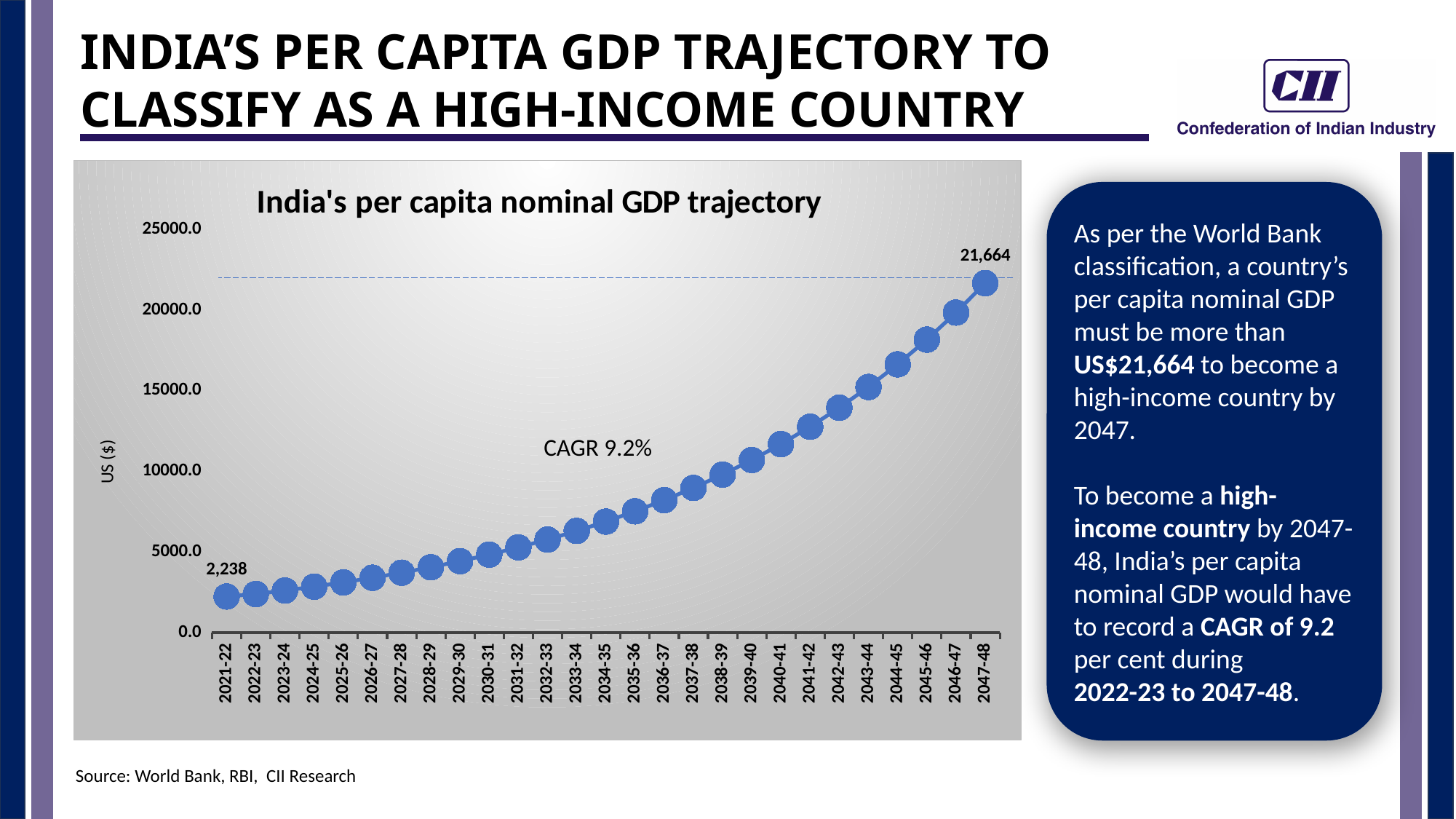
Which year has the lowest per capita nominal GDP on the chart? 2021-22 Is the value for 2044-45 greater or less than 15000? greater Which year has the highest per capita nominal GDP on the chart? 2047-48 Is the value for 2035-36 greater or less than 10000? less What is the per capita nominal GDP value shown for 2021-22? 2,238 Is the value for 2040-41 greater or less than 10000? greater What is the difference between the 2047-48 value and the 2021-22 value? 19,426 How many years are plotted on the x axis? 27 What kind of chart is shown on the slide? Line chart What CAGR is annotated on the chart? 9.2% Do the values rise or fall from 2021-22 to 2047-48? Rise What is the per capita nominal GDP value shown for 2047-48? 21,664